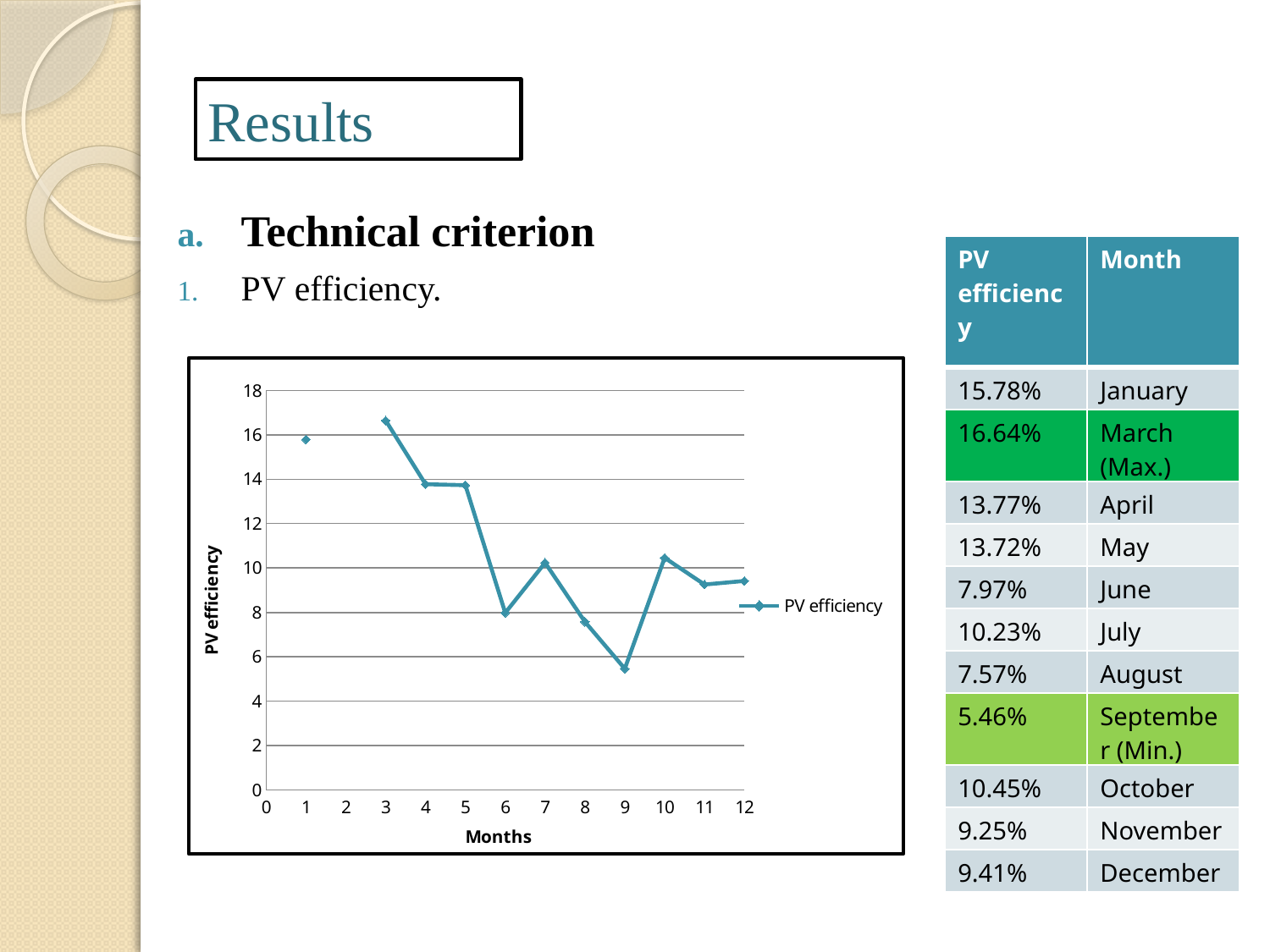
What is the title of the y axis of the chart? PV efficiency Is the PV efficiency value at month 3 greater or less than 16? greater Is the PV efficiency value at month 9 greater or less than 6? less What is the title of the x axis of the chart? Months Which has the higher PV efficiency value, month 6 or month 7? month 7 How many series does the chart's legend list? 1 Is the PV efficiency value at month 6 greater or less than 10? less Overall, does the PV efficiency line rise or fall from month 1 to month 12? fall At which month does the PV efficiency line reach its highest value? 3 What kind of chart is shown on the slide? line chart How many data points are plotted on the PV efficiency line? 11 At which month does the PV efficiency line reach its lowest value? 9